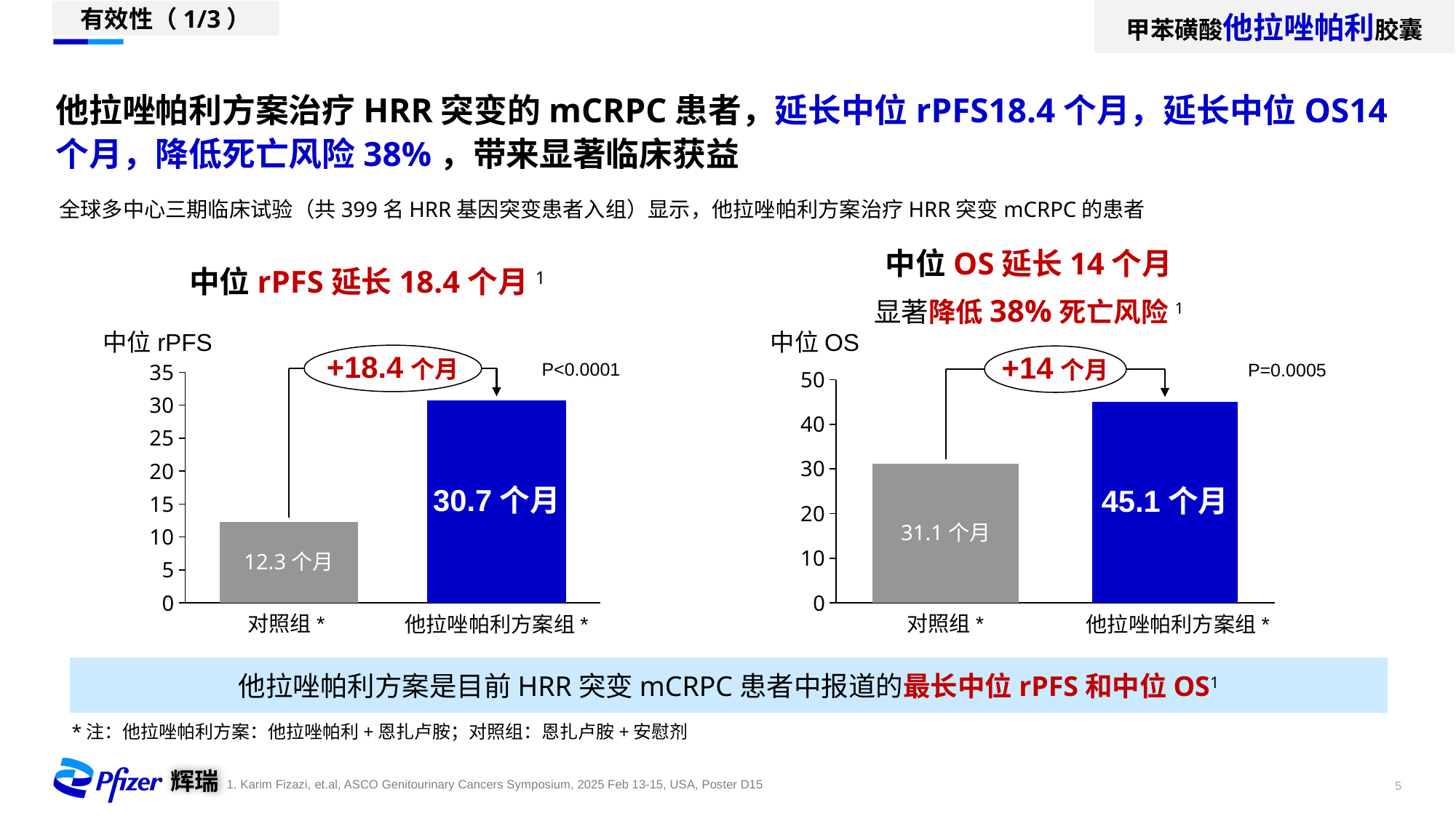
In the right chart (中位 OS), what is the value for 对照组? 31.1 个月 In the left chart (中位 rPFS), what p-value is shown? P<0.0001 How many bars are shown in the left chart (中位 rPFS)? 2 In the right chart (中位 OS), which group has the lower value? 对照组 In the left chart (中位 rPFS), what is the value for 对照组? 12.3 个月 In the left chart (中位 rPFS), what is the value for 他拉唑帕利方案组? 30.7 个月 In the right chart (中位 OS), what is the value for 他拉唑帕利方案组? 45.1 个月 In the right chart (中位 OS), is the value for 对照组 greater or less than 30? greater In the left chart (中位 rPFS), what is the difference between 他拉唑帕利方案组 and 对照组? 18.4 个月 In the right chart (中位 OS), what is the difference between 他拉唑帕利方案组 and 对照组? 14 个月 In the left chart (中位 rPFS), which group has the higher value? 他拉唑帕利方案组 What type of chart is the right chart (中位 OS)? Bar chart